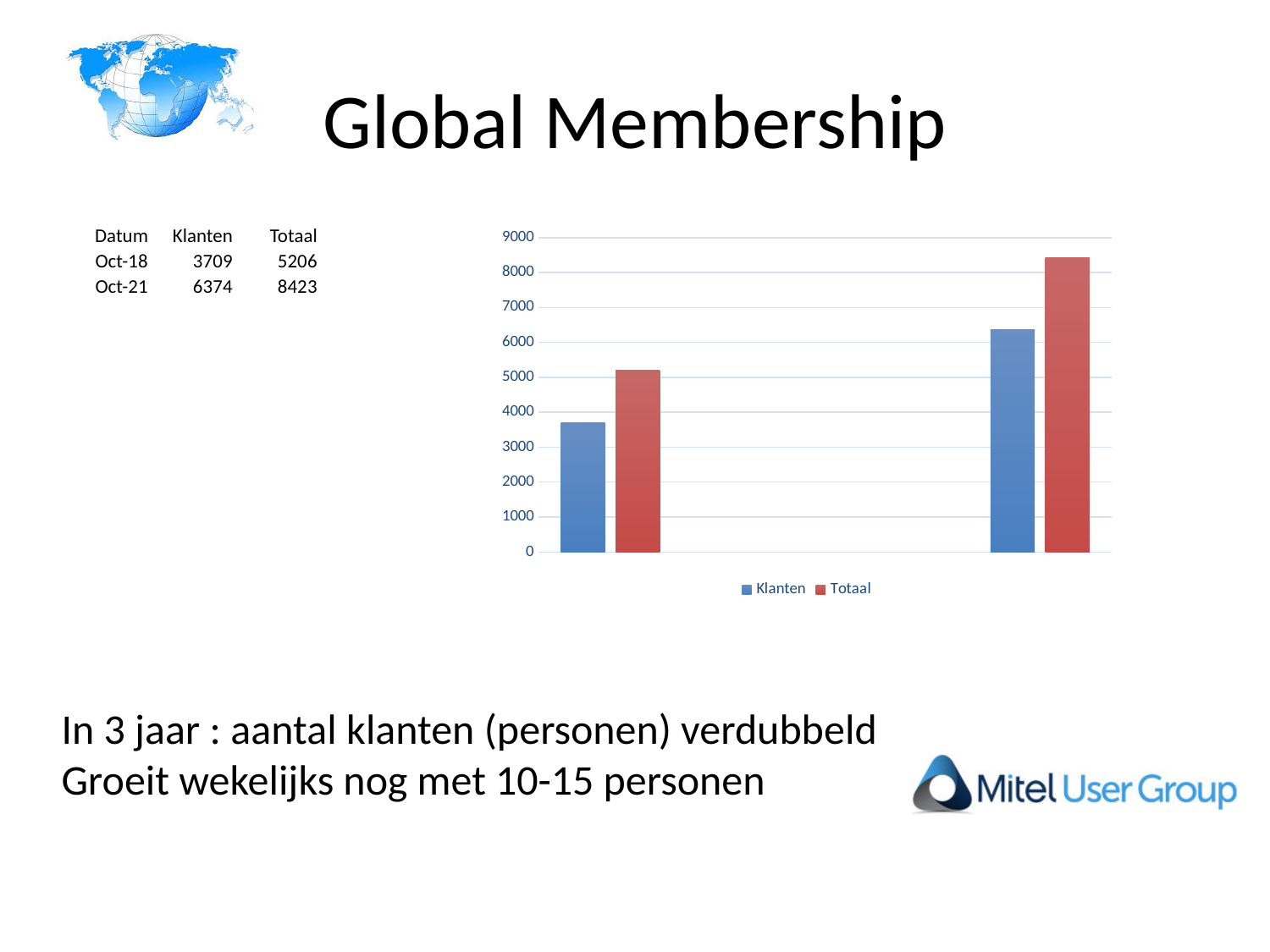
What are the two series named in the chart legend? Klanten and Totaal According to the table next to the chart, what is the Klanten value for Oct-18? 3709 Which bar is the tallest in the chart? Totaal for Oct-21 Which colour represents the Totaal series in the chart? red How many series does the chart legend list? 2 Which bar is the shortest in the chart? Klanten for Oct-18 What kind of chart is shown on the slide? bar chart Is the Totaal bar for the second group (Oct-21) greater or less than 8000? greater How many groups of bars are plotted in the chart? 2 According to the table next to the chart, what is the Totaal value for Oct-21? 8423 Is the Klanten bar for the first group (Oct-18) greater or less than 4000? less Using the values in the table, what is the difference between Totaal and Klanten for Oct-21? 2049